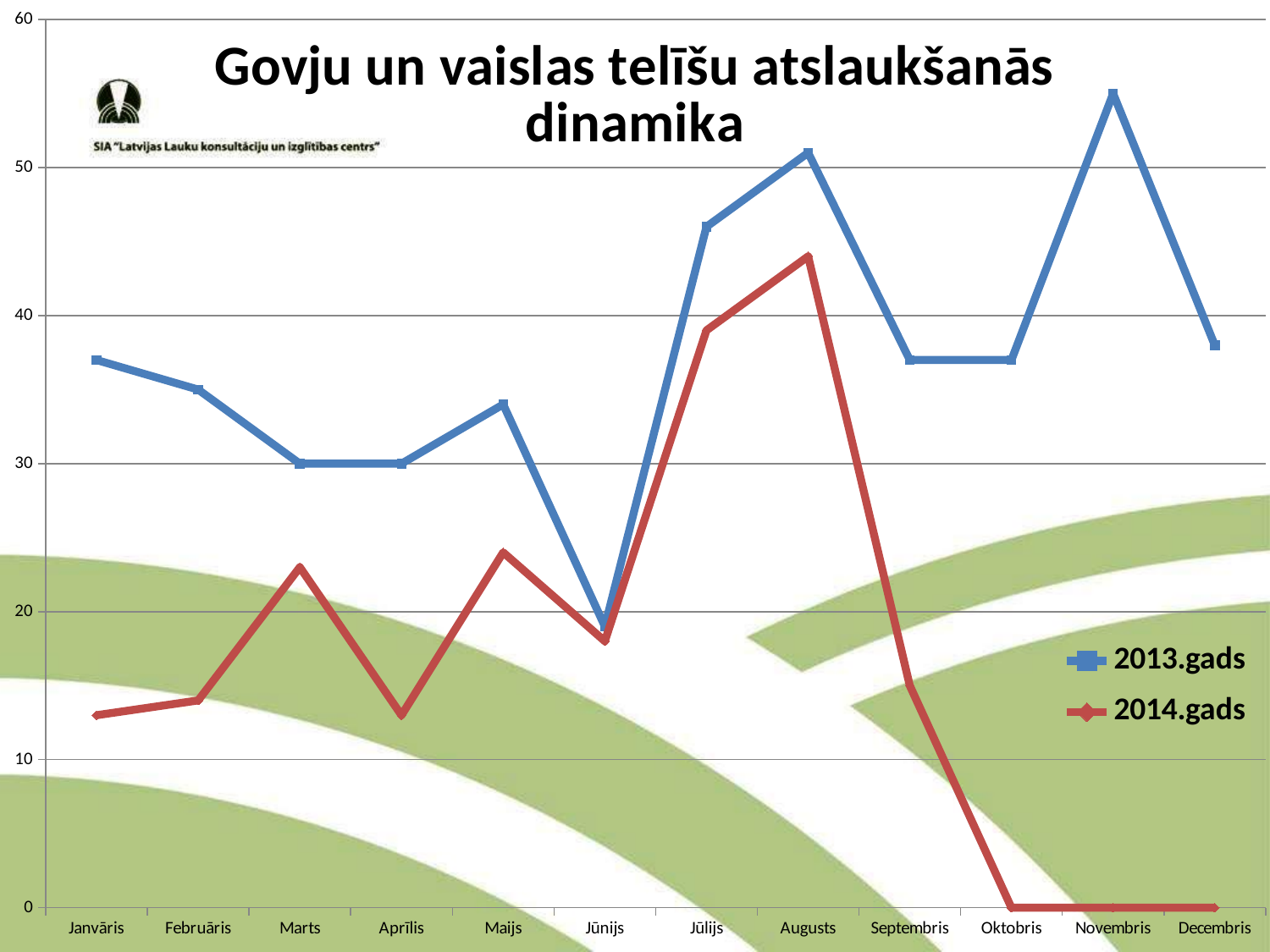
In which month is the 2014.gads series highest? Augusts What is the value for 2014.gads in Oktobris? 0 In which month is the 2013.gads series highest? Novembris What kind of chart is shown on the slide? line chart Is the value for 2014.gads in Janvāris greater or less than 20? less In which month is the 2013.gads series lowest? Jūnijs How many series does the legend list? 2 Does the 2014.gads series rise or fall from Augusts to Decembris? fall What is the value for 2013.gads in Marts? 30 Which series has the larger value in Maijs, 2013.gads or 2014.gads? 2013.gads How many months are shown along the x axis? 12 Is the value for 2013.gads in Jūlijs greater or less than 40? greater